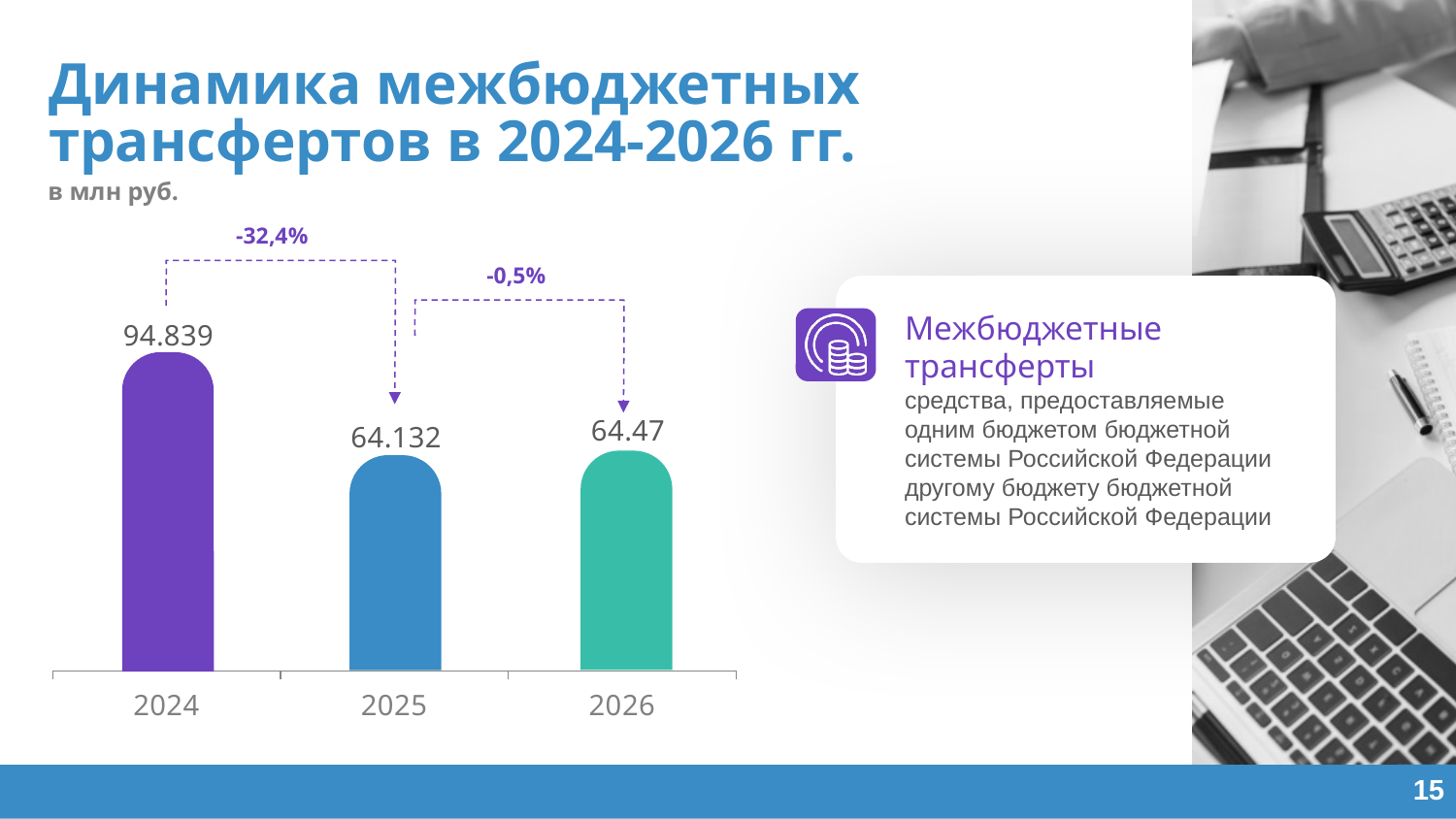
What is the value for 2025? 64.132 What is the value for 2024? 94.839 How many years are shown on the chart? 3 Does the value rise or fall from 2024 to 2025? Fall In what units are the chart values given? млн руб. Which is larger, the value for 2024 or the value for 2026? 2024 What percentage change is annotated between 2024 and 2025? -32,4% What percentage change is annotated between 2025 and 2026? -0,5% Which year has the highest value? 2024 What is the difference between the values for 2024 and 2025? 30.707 What kind of chart is shown on the slide? Bar chart What is the value for 2026? 64.47